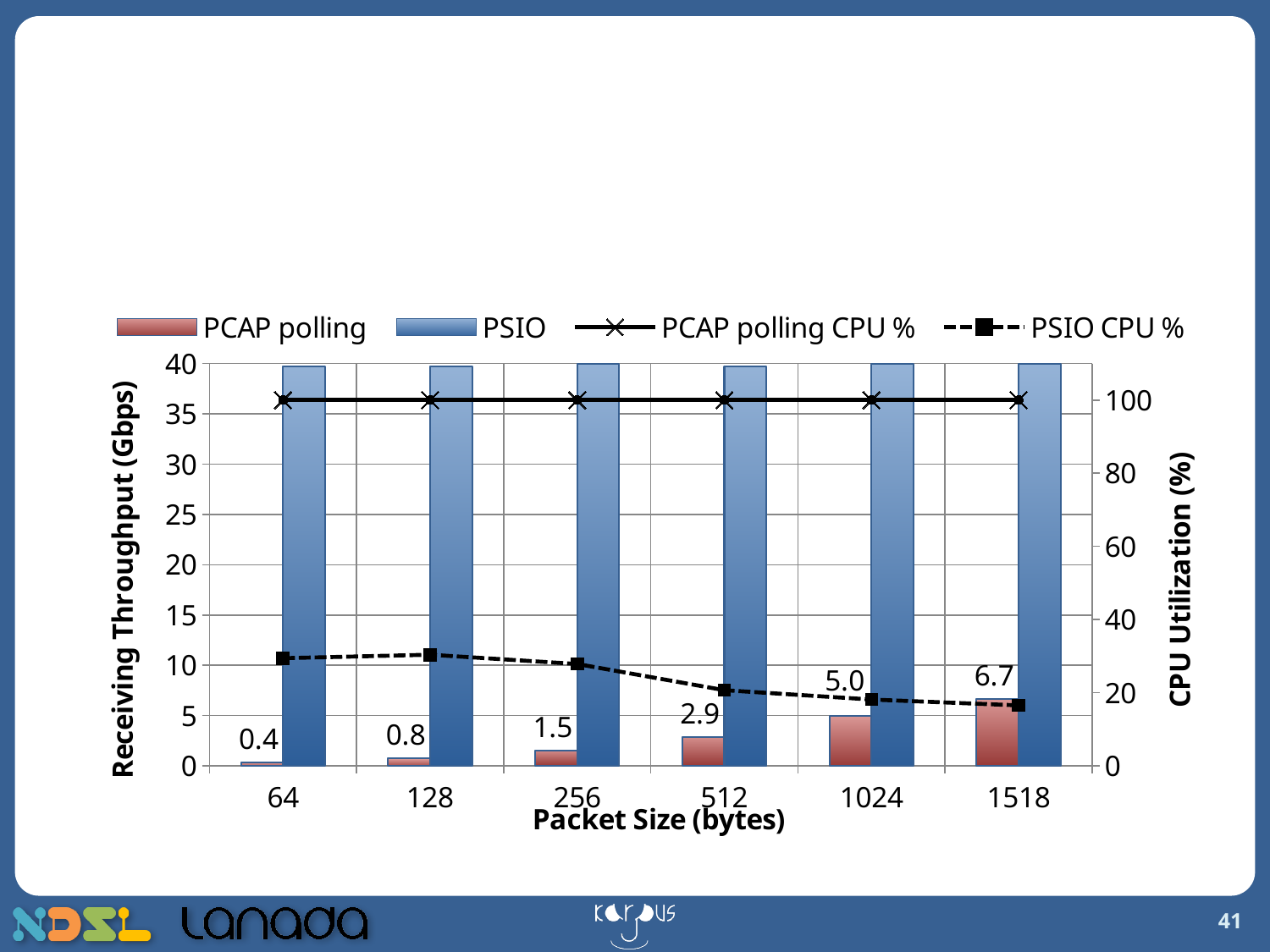
How many packet sizes are shown on the x axis? 6 What is the PCAP polling receiving throughput at a packet size of 64 bytes? 0.4 What is the difference between the PCAP polling throughput at 1518 bytes and at 1024 bytes? 1.7 What is the title of the left vertical axis? Receiving Throughput (Gbps) At which packet size is the PCAP polling throughput highest? 1518 Which has a higher PCAP polling throughput: 512 bytes or 256 bytes? 512 At which packet size is the PCAP polling throughput lowest? 64 Is the PSIO throughput at 64 bytes greater or less than 35? greater How many series does the legend list? 4 What is the PCAP polling receiving throughput at a packet size of 1518 bytes? 6.7 Does the PCAP polling throughput rise or fall as packet size increases? rises Is the PSIO CPU % value at 1518 bytes greater or less than 40? less